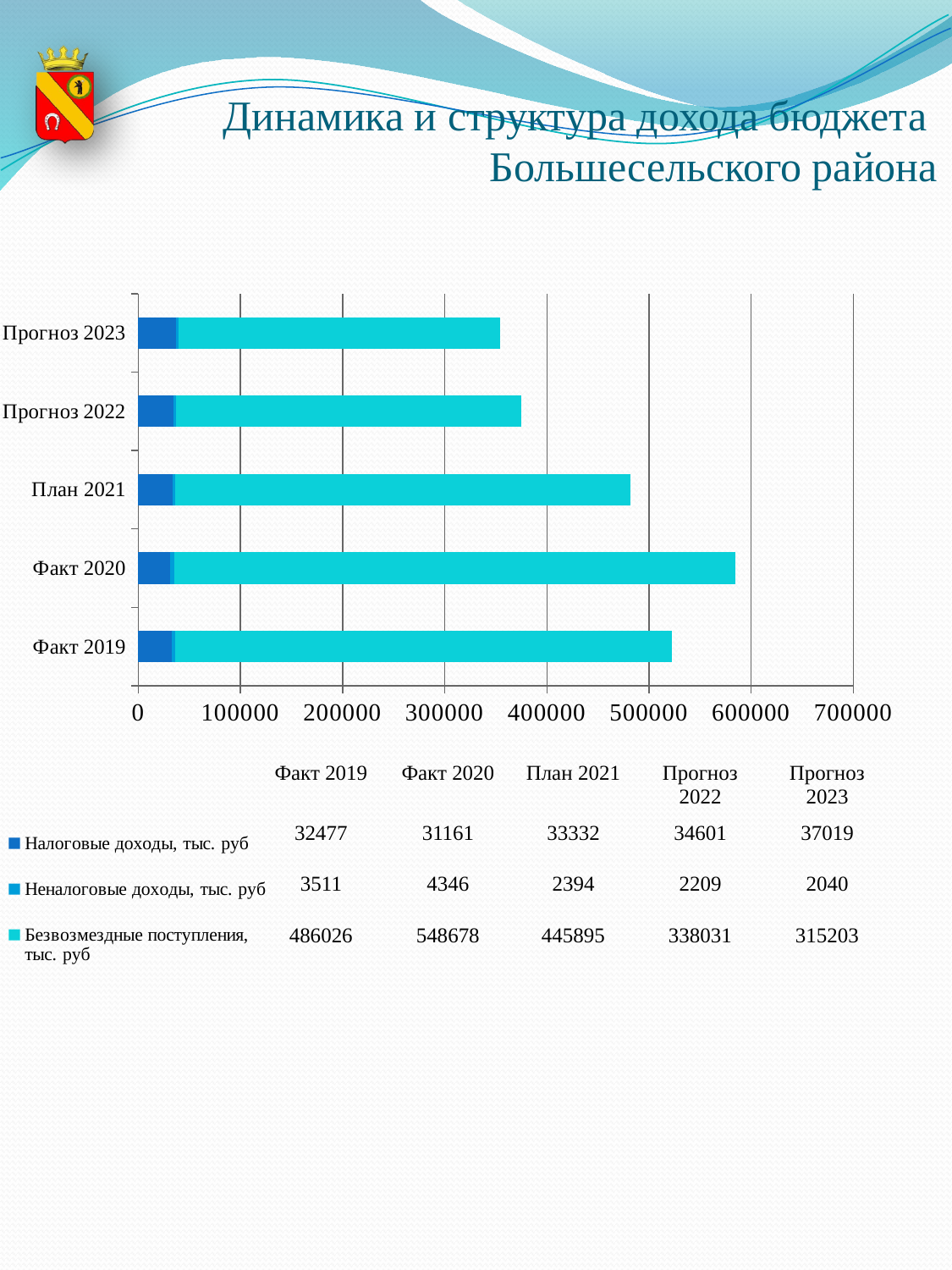
How many categories (years) are plotted on the chart? 5 What is the total of the stacked bar for Факт 2020? 584185 What type of chart is shown on the slide? Stacked bar chart What is the value of Безвозмездные поступления for Прогноз 2022? 338031 Is the total bar for Прогноз 2023 greater or less than 400000? less How many series does the legend list? 3 What is the value of Неналоговые доходы for План 2021? 2394 Which category has the highest value of Безвозмездные поступления? Факт 2020 What is the value of Налоговые доходы for Факт 2020? 31161 What is the difference between Налоговые доходы for Прогноз 2023 and Факт 2019? 4542 Which is larger: Безвозмездные поступления for Факт 2019 or for План 2021? Факт 2019 Which category has the lowest value of Неналоговые доходы? Прогноз 2023